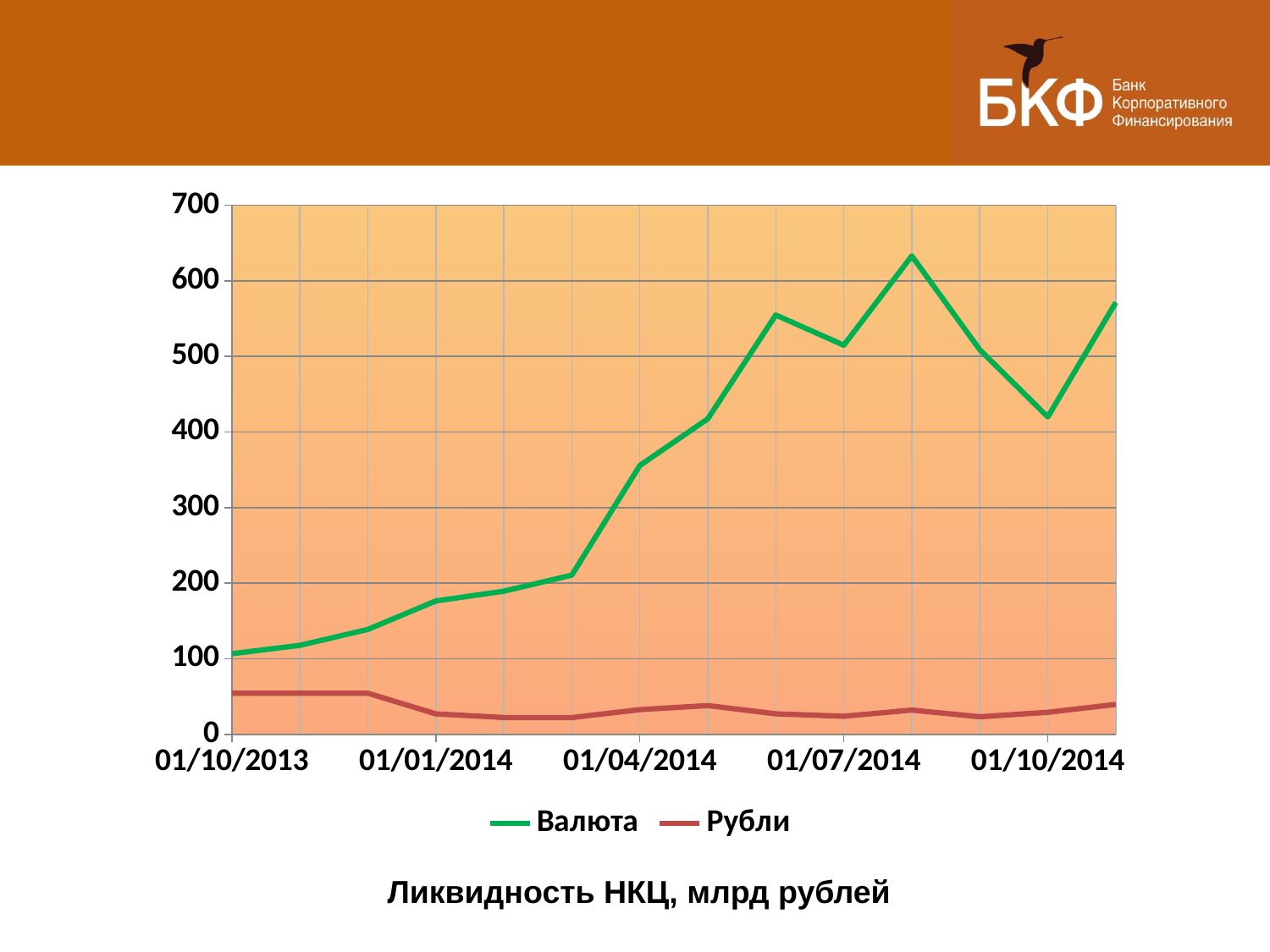
What are the two series named in the legend? Валюта and Рубли At 01/04/2014, which series has the larger value, Валюта or Рубли? Валюта What is the title shown below the chart? Ликвидность НКЦ, млрд рублей How many date labels are shown on the x axis? 5 Does the Валюта line rise or fall between 01/10/2013 and 01/04/2014? rise Is the value for Валюта at 01/01/2014 greater or less than 200? less Is the value for Рубли at 01/10/2013 greater or less than 100? less Is the value for Валюта at 01/10/2014 greater or less than 500? less How many series does the legend list? 2 What kind of chart is shown on the slide? line chart